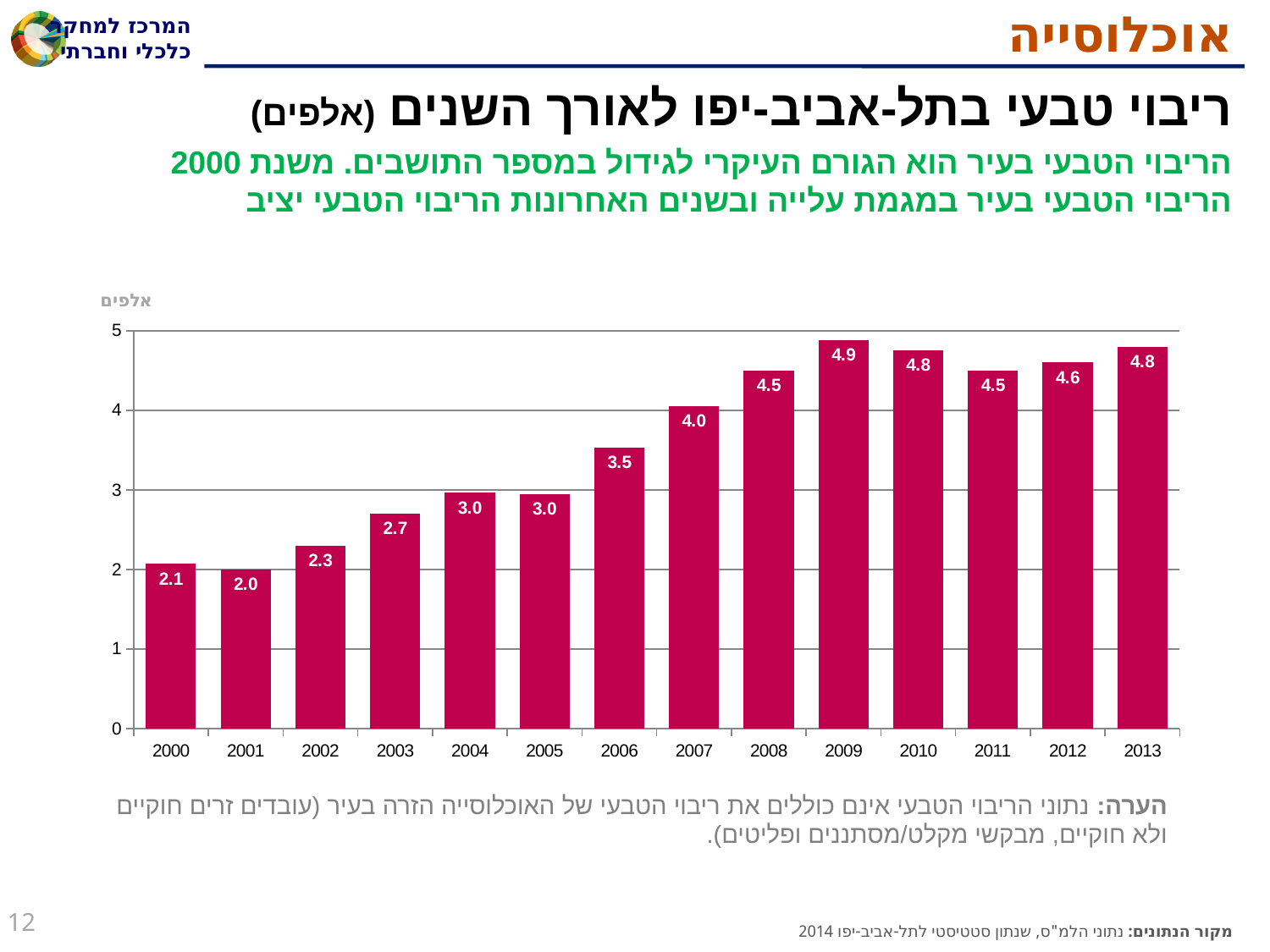
What is the value for 2000? 2.1 What kind of chart is shown on the slide? bar chart What is the difference between the values for 2009 and 2007? 0.9 What is the value for 2006? 3.5 What is the value for 2009? 4.9 What is the difference between the values for 2013 and 2000? 2.7 Do the values generally rise or fall from 2000 to 2013? rise Which is larger, the value for 2008 or the value for 2012? 2012 Is the value for 2007 greater or less than 3? greater How many years are shown on the x axis? 14 Which year has the highest value? 2009 Which year has the lowest value? 2001